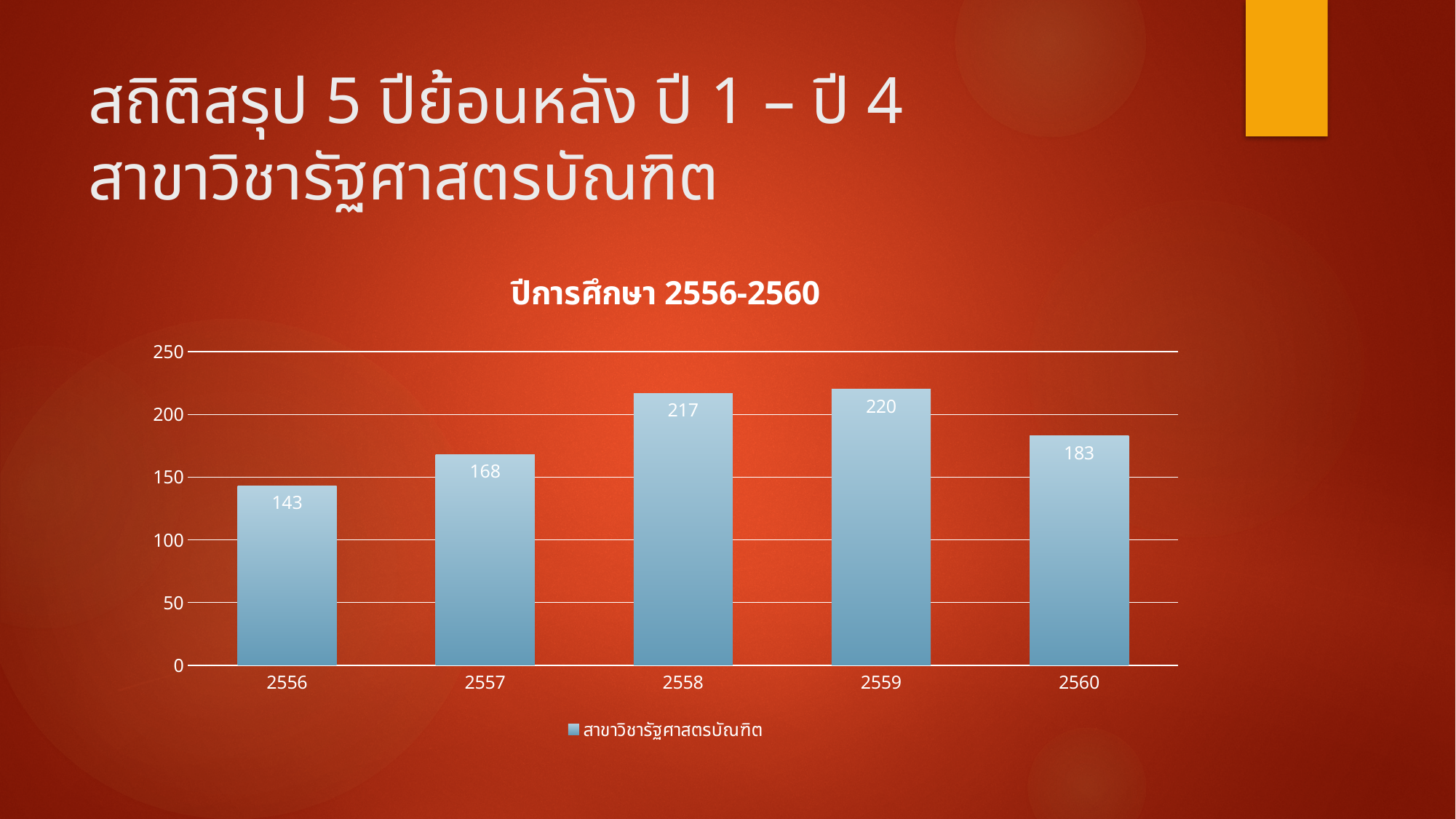
How many series does the legend list? 1 What kind of chart is shown? bar chart Which is larger, the value for 2557 or the value for 2560? 2560 What is the difference between the values for 2559 and 2556? 77 What is the difference between the values for 2557 and 2560? 15 What is the value for 2556? 143 How many years are shown on the x axis? 5 Which year has the lowest value? 2556 What is the value for 2558? 217 Which year has the highest value? 2559 What is the title of the chart? ปีการศึกษา 2556-2560 What is the value for 2560? 183